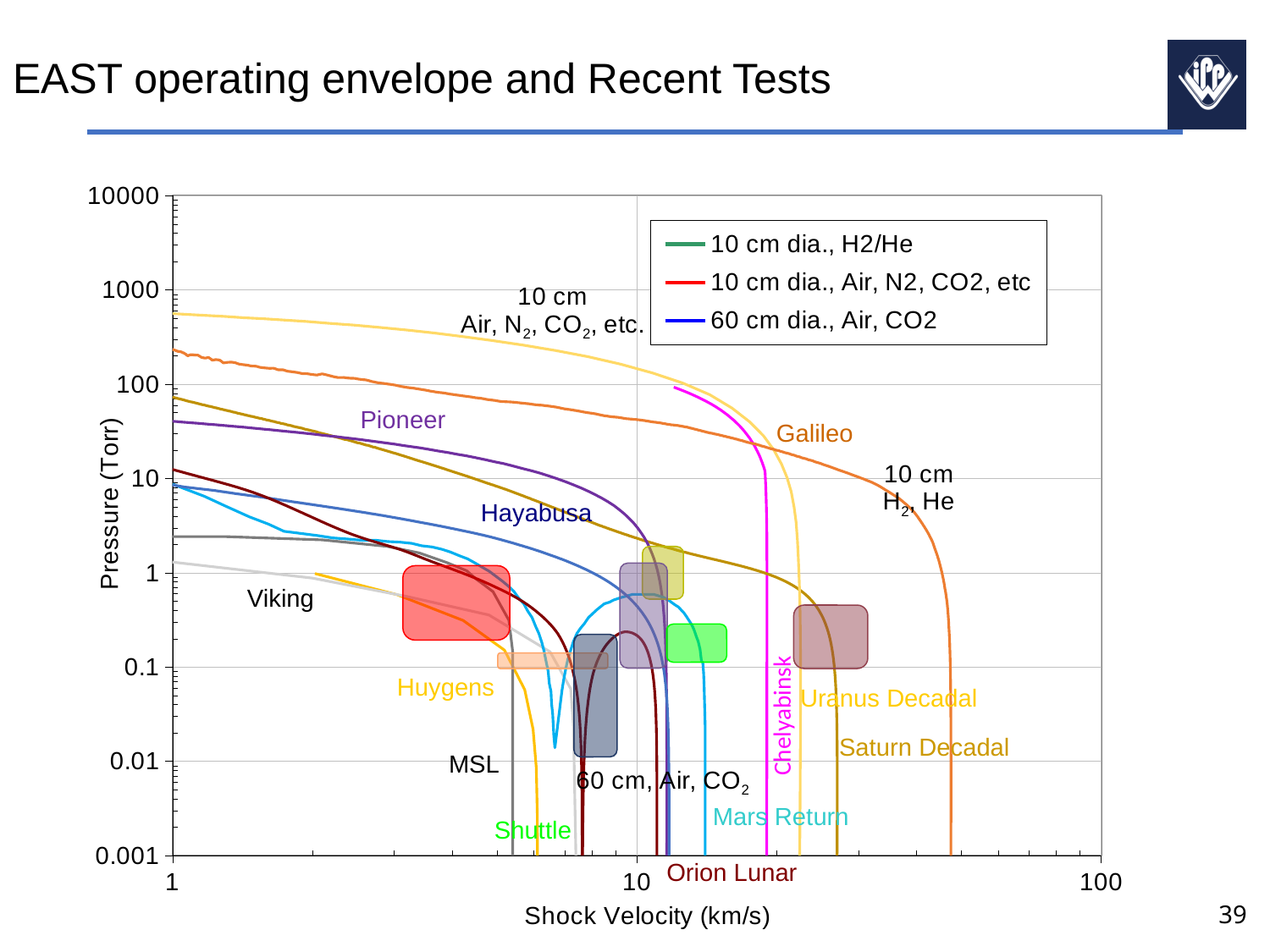
Is the pressure of the Viking curve at a shock velocity of 1 km/s greater or less than 1 Torr? greater Do the trajectory curves rise or fall in pressure as shock velocity increases along the x axis? fall What is the label of the x axis? Shock Velocity (km/s) What is the label of the y axis? Pressure (Torr) Is the pressure of the Galileo curve at a shock velocity of 1 km/s greater or less than 100 Torr? greater How many series does the legend list? 3 At a shock velocity of 1 km/s, which curve has the higher pressure, Pioneer or Viking? Pioneer What is the highest value shown on the y axis? 10000 Is the pressure of the Hayabusa curve at a shock velocity of 10 km/s greater or less than 1 Torr? less What kind of chart is shown on the slide? line chart